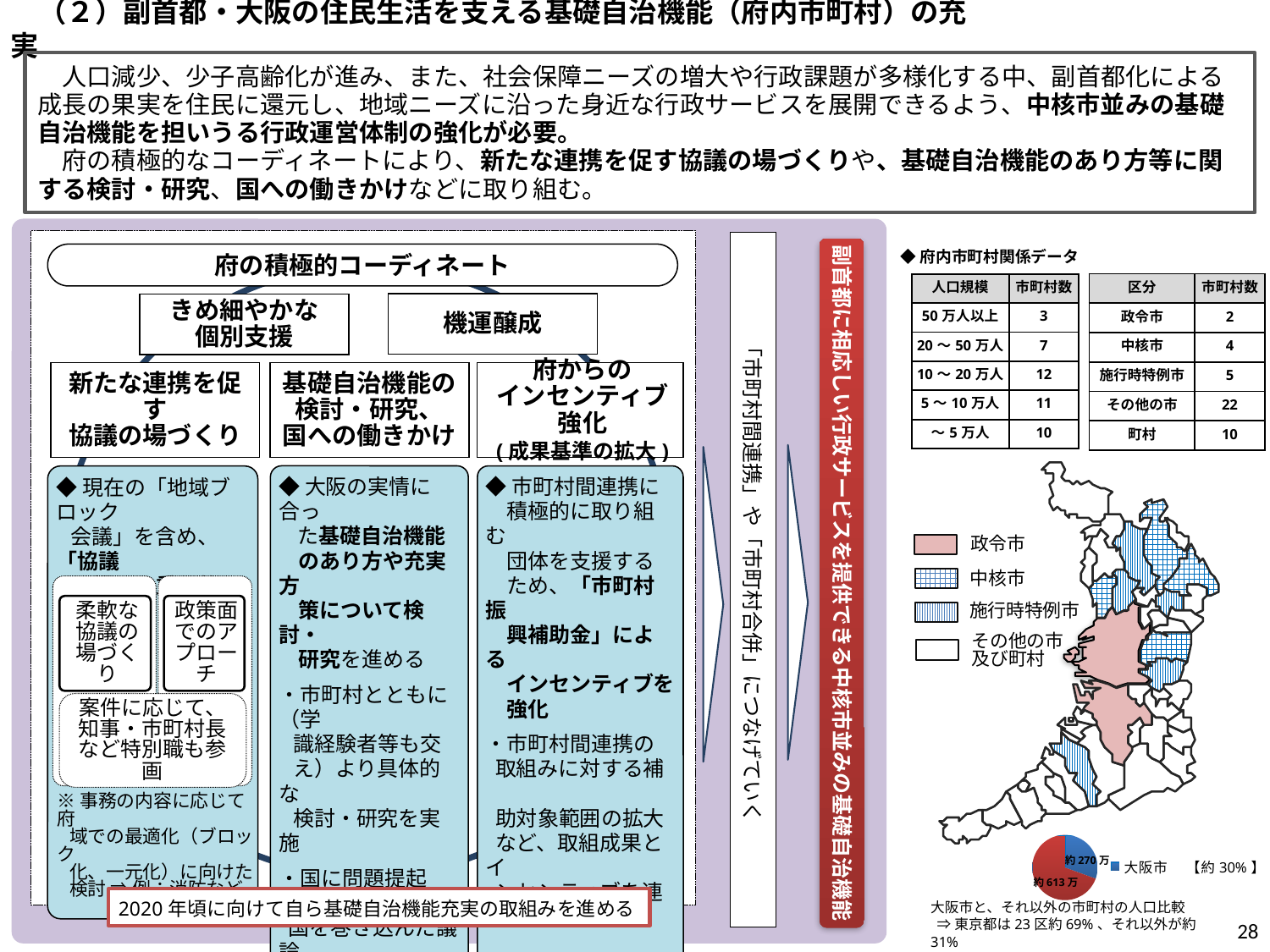
In the pie chart at the bottom right, is the share for 大阪市 greater or less than 50%? less What does the caption below the pie chart at the bottom right say the chart compares? 大阪市と、それ以外の市町村の人口比較 In the pie chart at the bottom right, which slice is the smallest? 大阪市 In the pie chart at the bottom right, what colour is the 大阪市 slice? blue In the pie chart at the bottom right, what value is printed on the red slice (それ以外の市町村)? 約613万 In the pie chart at the bottom right, which slice is larger: 大阪市 or それ以外の市町村? それ以外の市町村 How many slices does the pie chart at the bottom right of the slide have? 2 In the pie chart at the bottom right, what value is printed for 大阪市? 約270万 What kind of chart is shown at the bottom right of the slide, below the map? pie chart In the pie chart at the bottom right, what share of the total is shown for 大阪市? 約30%